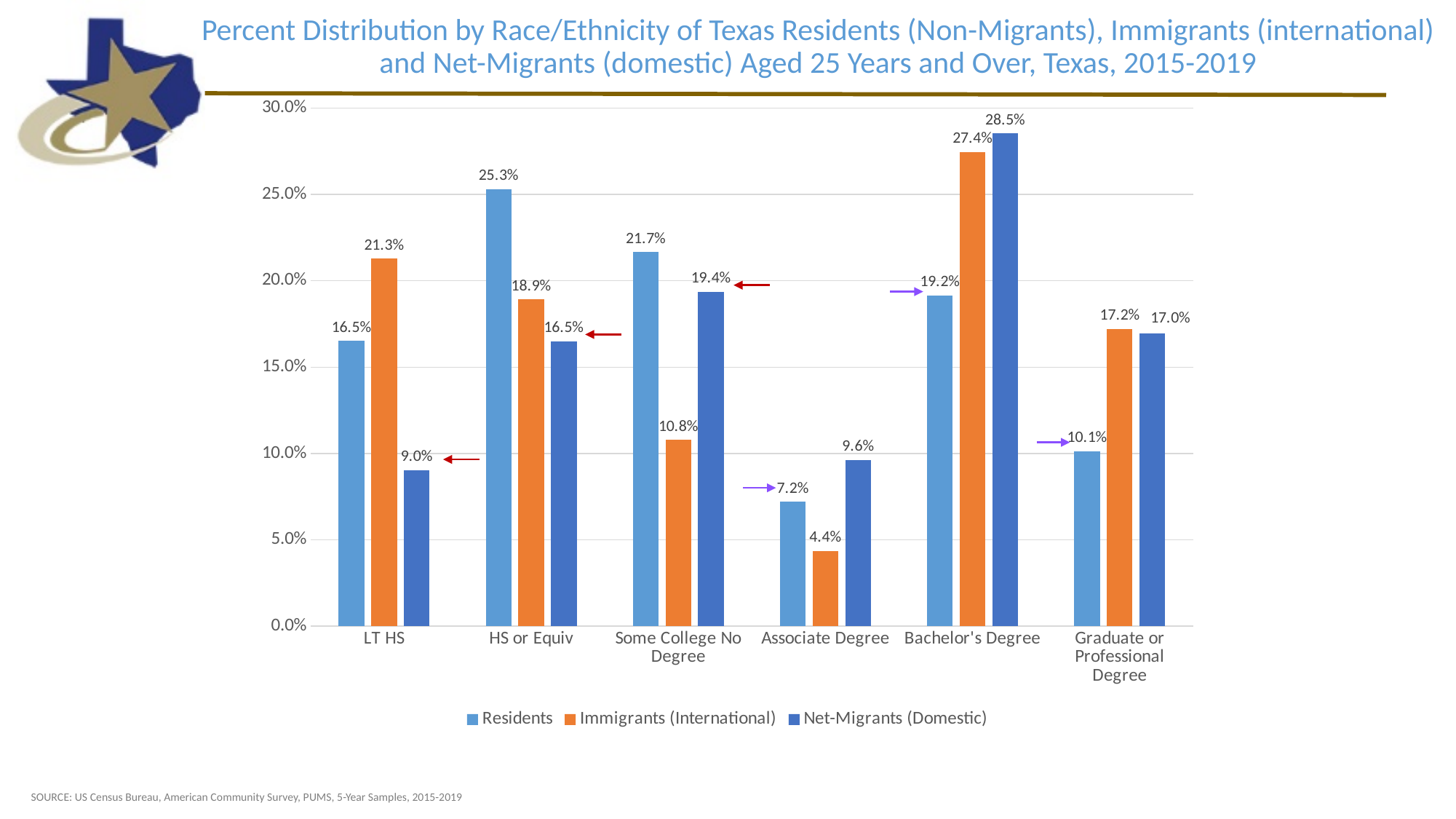
What is the value for Net-Migrants (Domestic) in the Bachelor's Degree category? 28.5% What is the value for Immigrants (International) in the LT HS category? 21.3% What kind of chart is shown on the slide? Bar chart What is the value for Residents in the Some College No Degree category? 21.7% What is the difference between the Immigrants (International) and Residents values in the Bachelor's Degree category? 8.2% In the Associate Degree category, which series has the larger value: Residents or Net-Migrants (Domestic)? Net-Migrants (Domestic) Which series is shown in orange in the legend? Immigrants (International) Which category has the highest value for Residents? HS or Equiv Which category has the lowest value for Immigrants (International)? Associate Degree How many series does the legend list? 3 What is the difference between the Residents and Net-Migrants (Domestic) values in the LT HS category? 7.5% How many education categories are shown on the x axis? 6